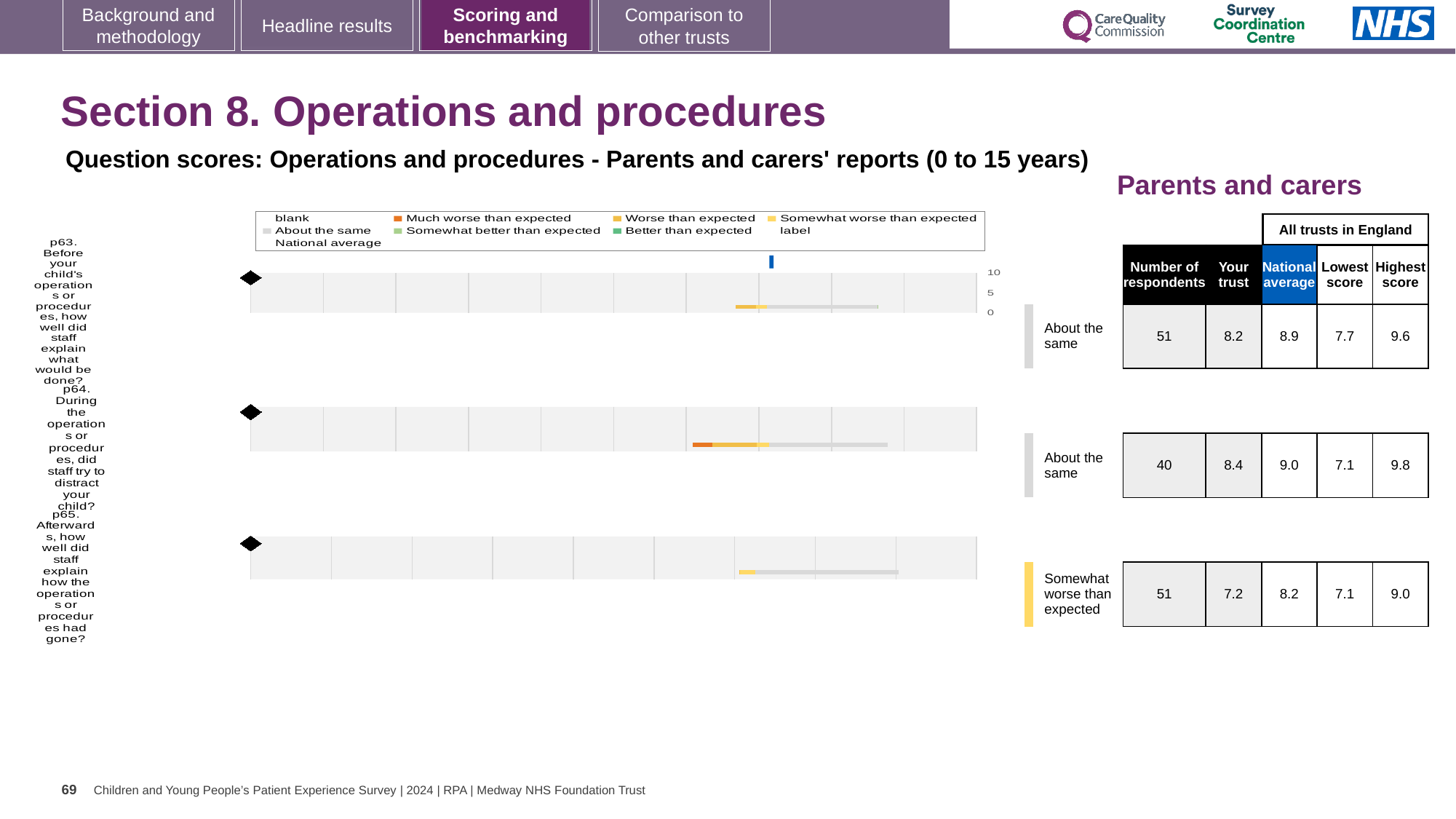
Which benchmark category is shown for p65? Somewhat worse than expected Is the 'Your trust' score for p63 greater or less than 5? greater What kind of chart is used to show the question scores for p63, p64 and p65? bar chart What is the difference between the national average and the 'Your trust' score for p65? 1.0 Which question has the lowest 'Your trust' score? p65 Which has the higher 'Your trust' score, p63 or p64? p64 What is the 'Your trust' score for p63 (how well staff explained what would be done before the operation)? 8.2 How many questions (p63, p64, p65) are plotted on the slide? 3 What is the national average score for p64 (did staff try to distract your child during the operation)? 9.0 Which question has the highest 'Your trust' score? p64 What is the lowest score among all trusts in England for p63? 7.7 How many respondents answered p65 (how well staff explained how the operation had gone)? 51